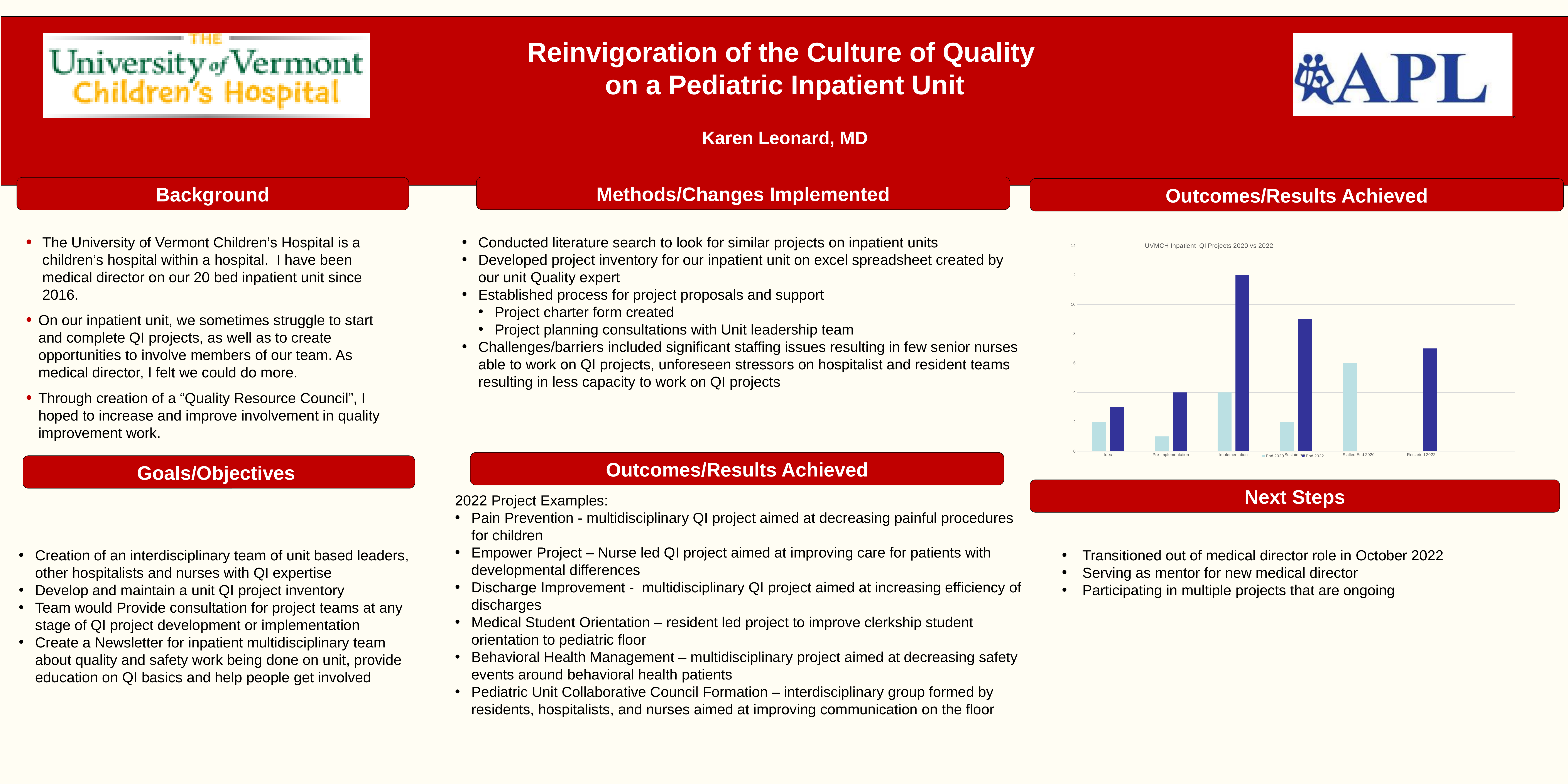
Is the End 2022 value for Restarted 2022 greater or less than 8? less Which series is shown in light blue in the chart? End 2020 Is the End 2020 value for Stalled End 2020 greater or less than 4? greater Is the End 2022 value for Implementation greater or less than 10? greater How many series does the legend of the chart list? 2 How many categories are shown on the x axis of the chart? 6 What kind of chart is shown under Outcomes/Results Achieved on the right? bar chart For Implementation, which is larger: the End 2020 bar or the End 2022 bar? End 2022 Which category has the highest End 2022 bar in the chart? Implementation What is the title of the chart on the right side of the slide? UVMCH Inpatient QI Projects 2020 vs 2022